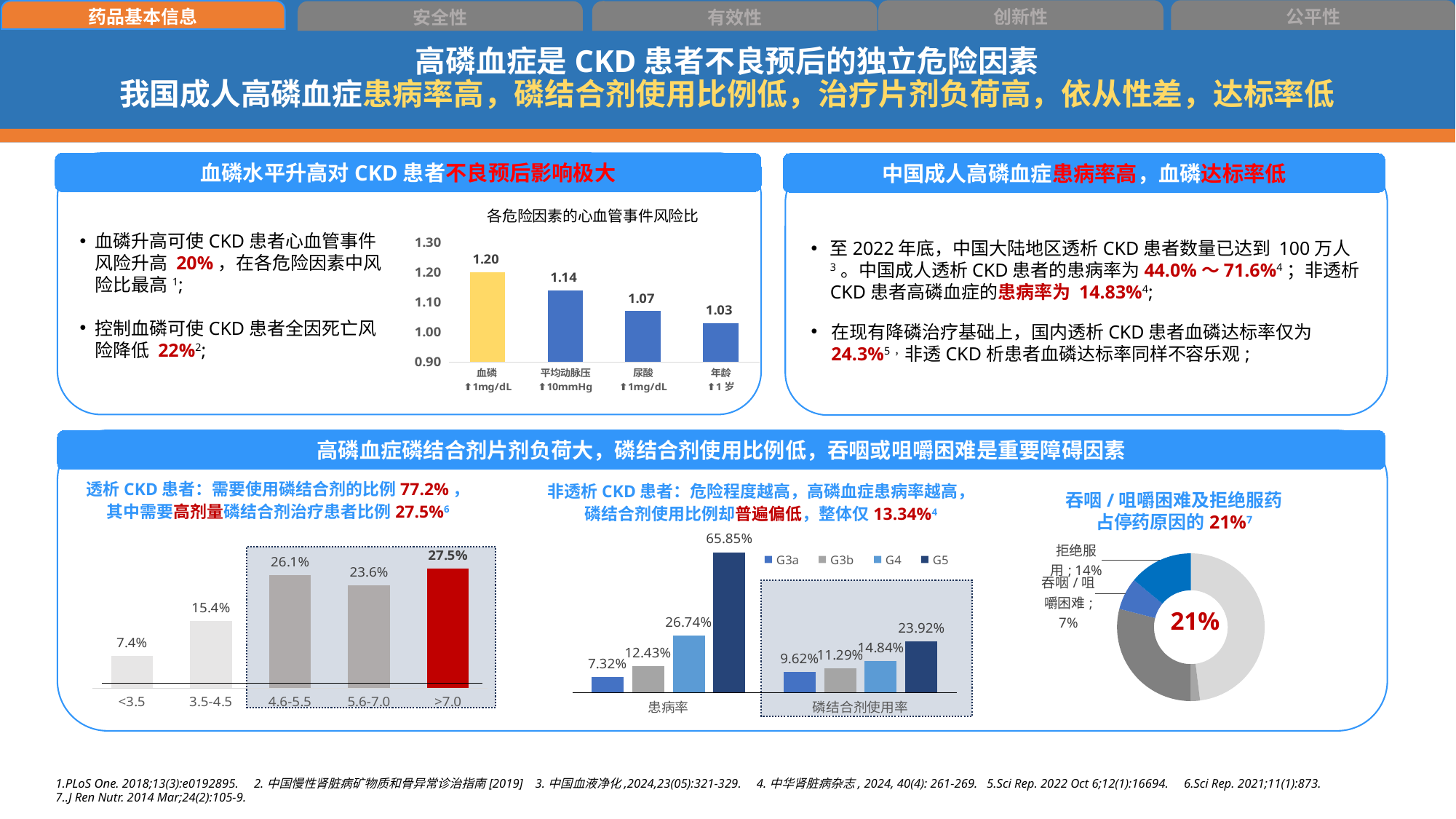
In the bottom-left bar chart (透析 CKD 患者), which is larger, the value for 4.6-5.5 or the value for 5.6-7.0? 4.6-5.5 In the bottom-middle bar chart (非透析 CKD 患者), how many series does the legend list? 4 In the chart titled 各危险因素的心血管事件风险比, what is the value for 血磷? 1.20 In the bottom-middle bar chart (非透析 CKD 患者), what is the 磷结合剂使用率 value for G3a? 9.62% In the chart titled 各危险因素的心血管事件风险比, which category has the lowest value? 年龄 In the chart titled 各危险因素的心血管事件风险比, what is the difference between the values for 血磷 and 平均动脉压? 0.06 In the bottom-middle bar chart (非透析 CKD 患者), what is the 患病率 value for G5? 65.85% In the bottom-left bar chart (透析 CKD 患者), what is the value for the 3.5-4.5 category? 15.4% In the bottom-middle bar chart (非透析 CKD 患者), what is the difference between the 患病率 and 磷结合剂使用率 values for G4? 11.90% What kind of chart is the bottom-right chart showing 吞咽/咀嚼困难及拒绝服药? Donut (pie) chart In the bottom-left bar chart (透析 CKD 患者), which category has the highest value? >7.0 In the chart titled 各危险因素的心血管事件风险比, how many categories are shown? 4